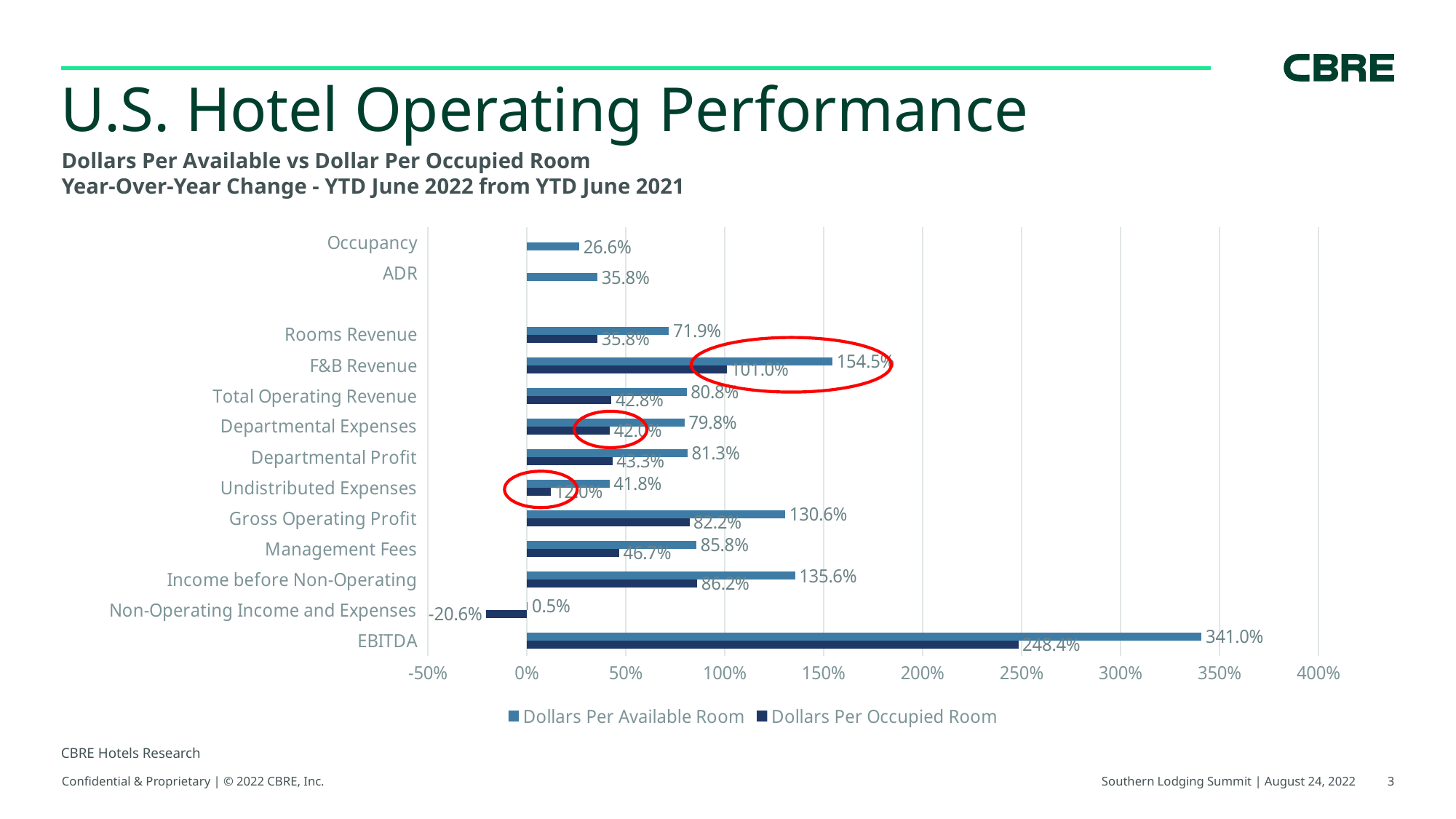
Which category has the lowest Dollars Per Occupied Room value? Non-Operating Income and Expenses Is the Dollars Per Occupied Room value for Management Fees greater or less than 50%? less What kind of chart is shown on the slide? Bar chart Which category has the highest Dollars Per Available Room value? EBITDA Which has the larger Dollars Per Available Room value: Rooms Revenue or Total Operating Revenue? Total Operating Revenue How many series does the legend list? 2 What are the two series named in the legend? Dollars Per Available Room and Dollars Per Occupied Room What is the value shown for Occupancy? 26.6% For Gross Operating Profit, what is the difference between the Dollars Per Available Room value and the Dollars Per Occupied Room value? 48.4 percentage points What is the Dollars Per Occupied Room value for F&B Revenue? 101.0% How many categories are listed on the vertical axis of the chart? 13 What is the Dollars Per Available Room value for EBITDA? 341.0%